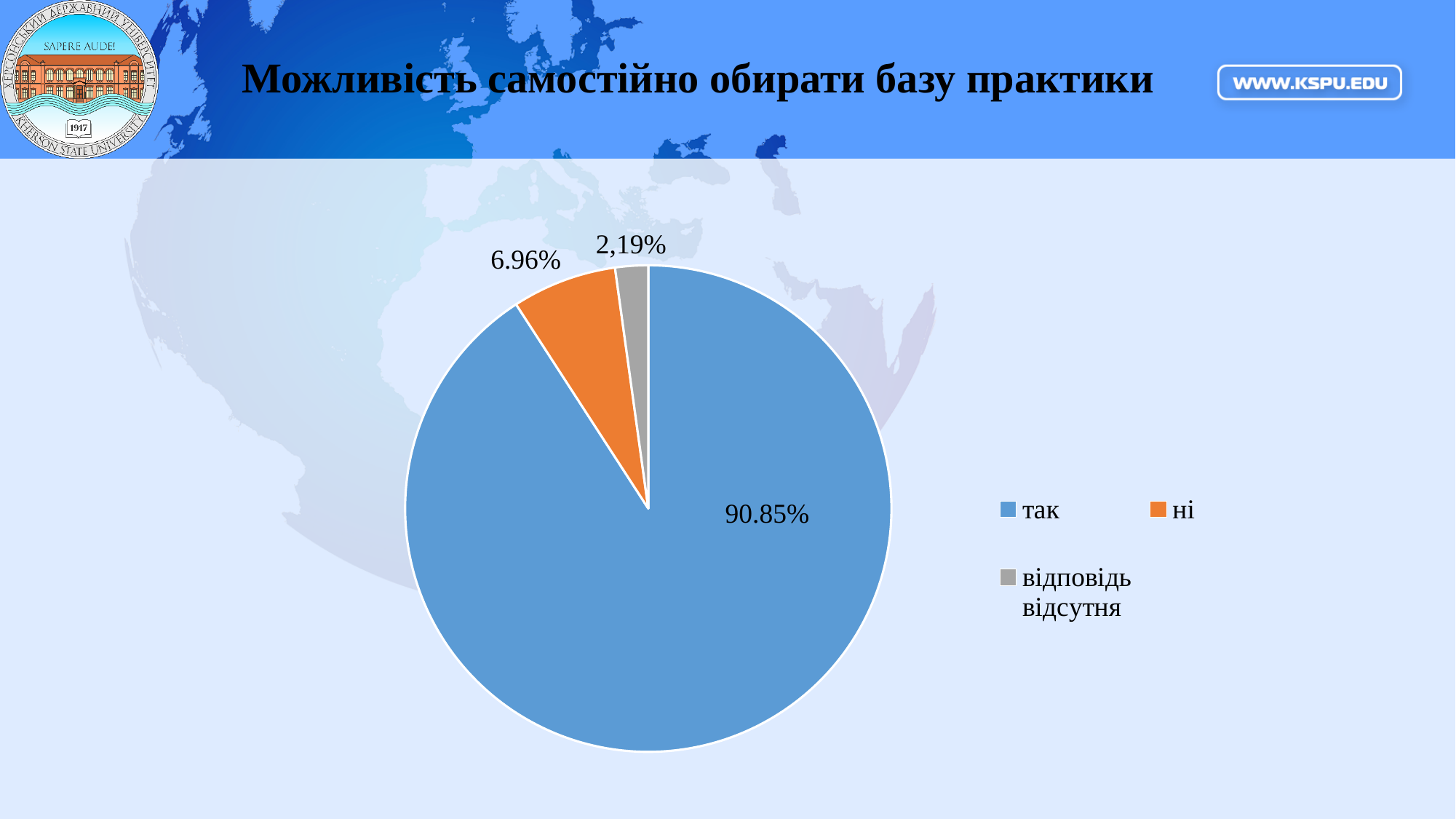
What share of the pie does the "ні" slice have? 6.96% Is the share for "так" greater or less than 50%? greater How many slices does the pie chart have? 3 Which category has the largest slice of the pie? так What colour is the "ні" slice in the pie chart? orange What share of the pie does the "так" slice have? 90.85% What share of the pie does the "відповідь відсутня" slice have? 2,19% What colour is the "так" slice in the pie chart? blue How many entries does the legend list? 3 Which slice is larger, "ні" or "відповідь відсутня"? ні Which category has the smallest slice of the pie? відповідь відсутня What kind of chart is shown on the slide? pie chart